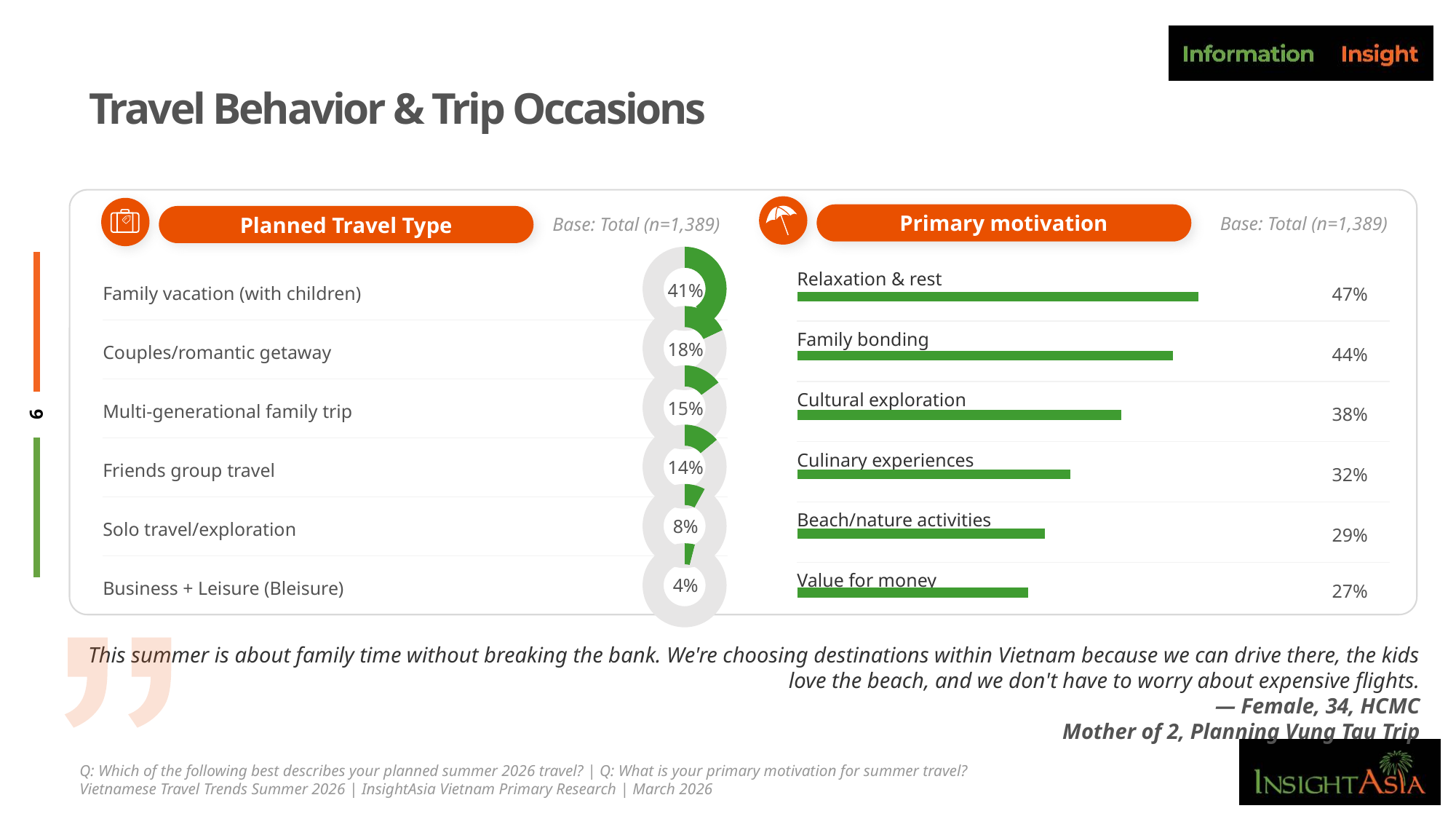
In the Primary motivation chart, what percentage is shown for Cultural exploration? 38% What kind of chart is the Primary motivation chart? Bar chart In the Planned Travel Type chart, which travel type has the lowest percentage? Business + Leisure (Bleisure) What is the base sample size shown for the Primary motivation chart? Total (n=1,389) How many travel types are listed in the Planned Travel Type chart? 6 In the Primary motivation chart, which motivation has the highest percentage? Relaxation & rest In the Planned Travel Type chart, what percentage is shown for Family vacation (with children)? 41% In the Primary motivation chart, what is the difference between Relaxation & rest and Family bonding? 3% In the Planned Travel Type chart, what percentage is shown for Solo travel/exploration? 8% In the Primary motivation chart, what percentage is shown for Value for money? 27% In the Primary motivation chart, which is larger: Culinary experiences or Beach/nature activities? Culinary experiences In the Planned Travel Type chart, what is the difference between Couples/romantic getaway and Multi-generational family trip? 3%